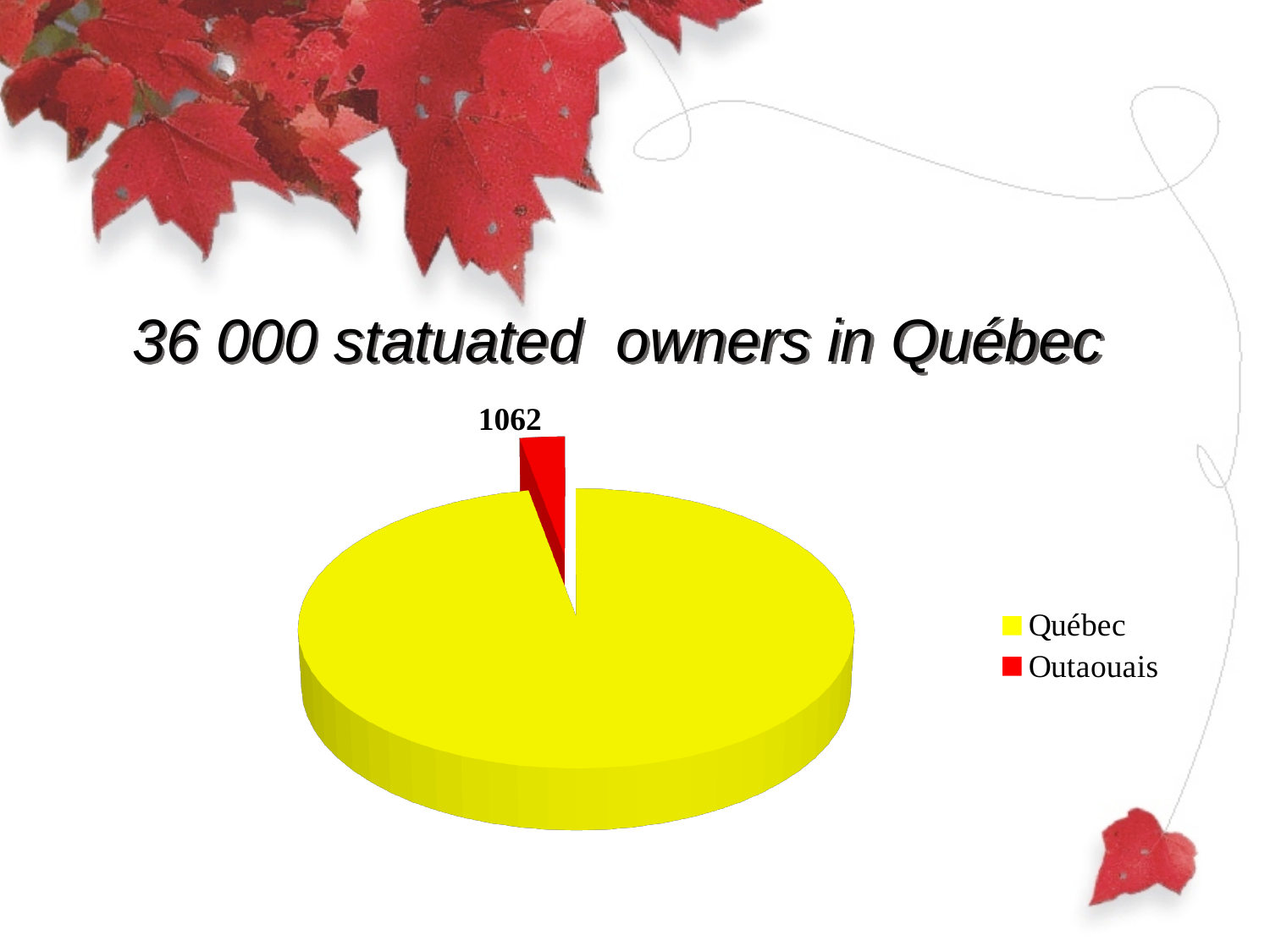
How many entries does the legend of the pie chart list? 2 What value is labelled on the Outaouais slice of the pie chart? 1062 Which is larger in the pie chart, the Québec slice or the Outaouais slice? Québec How many slices does the pie chart have? 2 What kind of chart is shown on the slide? pie chart What colour is the Outaouais slice in the pie chart? red Which slice of the pie chart is the smallest? Outaouais What is the title shown above the pie chart? 36 000 statuated owners in Québec Which slice of the pie chart is the largest? Québec